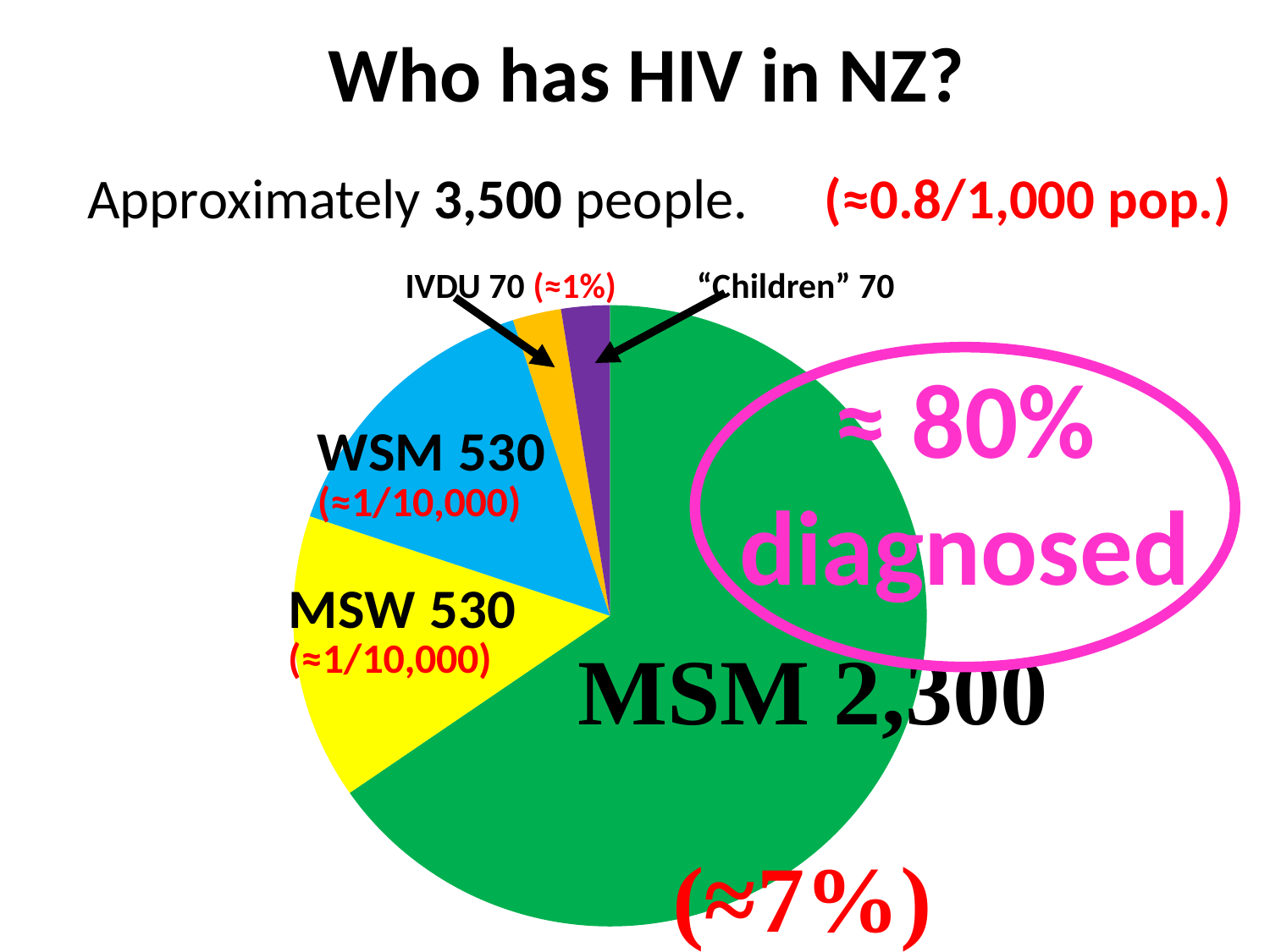
What is the difference between the MSM value and the MSW value? 1,770 What is the value shown for the MSW slice? 530 Which category has the largest slice of the pie chart? MSM What kind of chart is shown on the slide? Pie chart What is the title of the slide containing the pie chart? Who has HIV in NZ? Which is larger, the MSM slice or the WSM slice? MSM What is the value shown for the WSM slice? 530 What is the value shown for the IVDU slice? 70 What is the difference between the WSM value and the IVDU value? 460 What is the value shown for the MSM slice of the pie chart? 2,300 What is the value shown for the "Children" slice? 70 How many slices does the pie chart have? 5